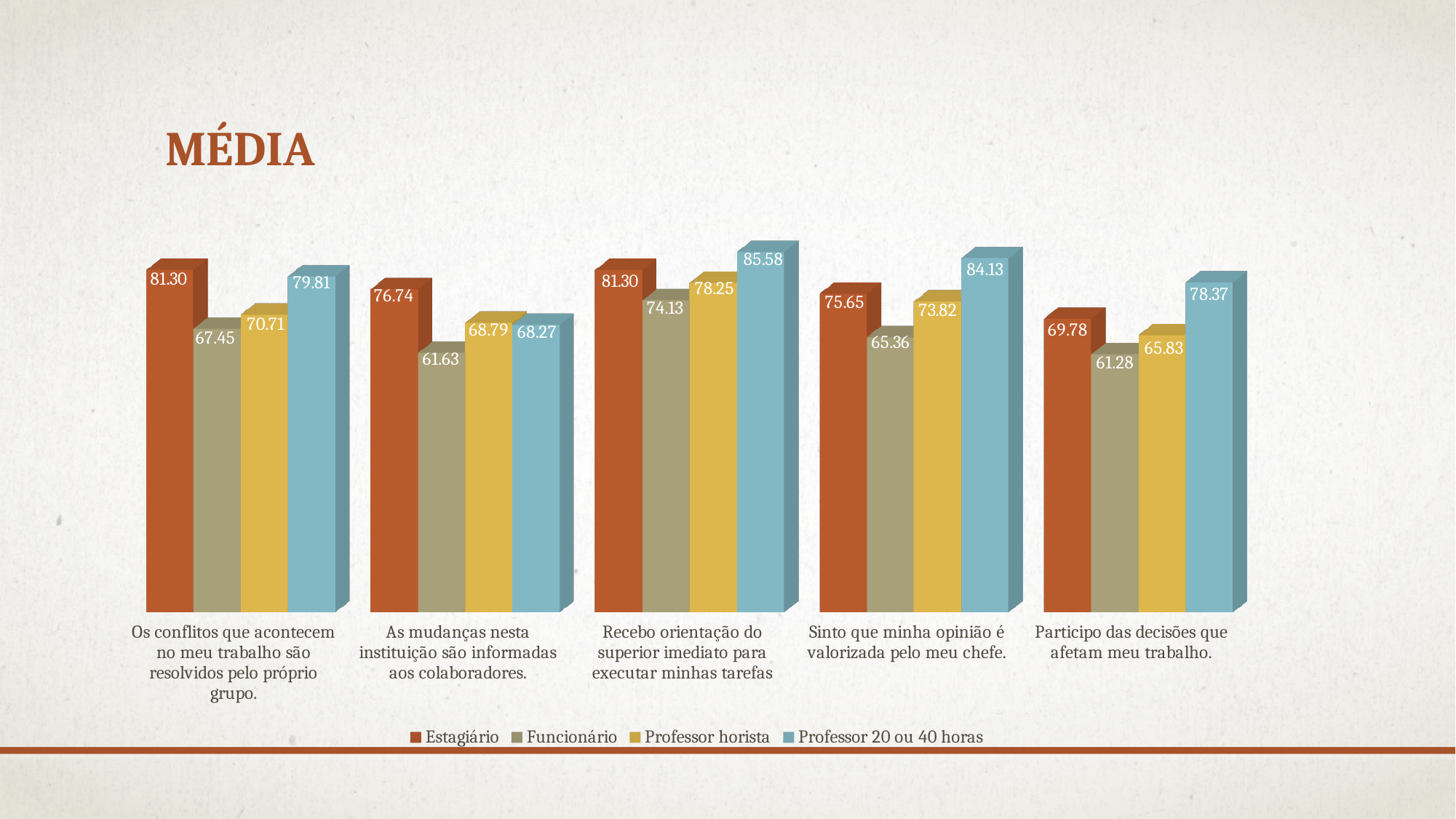
What is the value for Estagiário in the category "Os conflitos que acontecem no meu trabalho são resolvidos pelo próprio grupo."? 81.30 What is the value for Professor horista in the category "Sinto que minha opinião é valorizada pelo meu chefe."? 73.82 Which series has the highest value in the category "Participo das decisões que afetam meu trabalho."? Professor 20 ou 40 horas How many series does the legend list? 4 What is the title of the chart? MÉDIA What kind of chart is shown on the slide? Bar chart What is the value for Funcionário in the category "As mudanças nesta instituição são informadas aos colaboradores."? 61.63 What is the value for Professor 20 ou 40 horas in the category "Recebo orientação do superior imediato para executar minhas tarefas"? 85.58 In the category "As mudanças nesta instituição são informadas aos colaboradores.", which is larger: Professor horista or Professor 20 ou 40 horas? Professor horista How many categories are shown on the x axis? 5 Which series has the lowest value in the category "Sinto que minha opinião é valorizada pelo meu chefe."? Funcionário What is the difference between the Estagiário and Funcionário values in the category "Os conflitos que acontecem no meu trabalho são resolvidos pelo próprio grupo."? 13.85